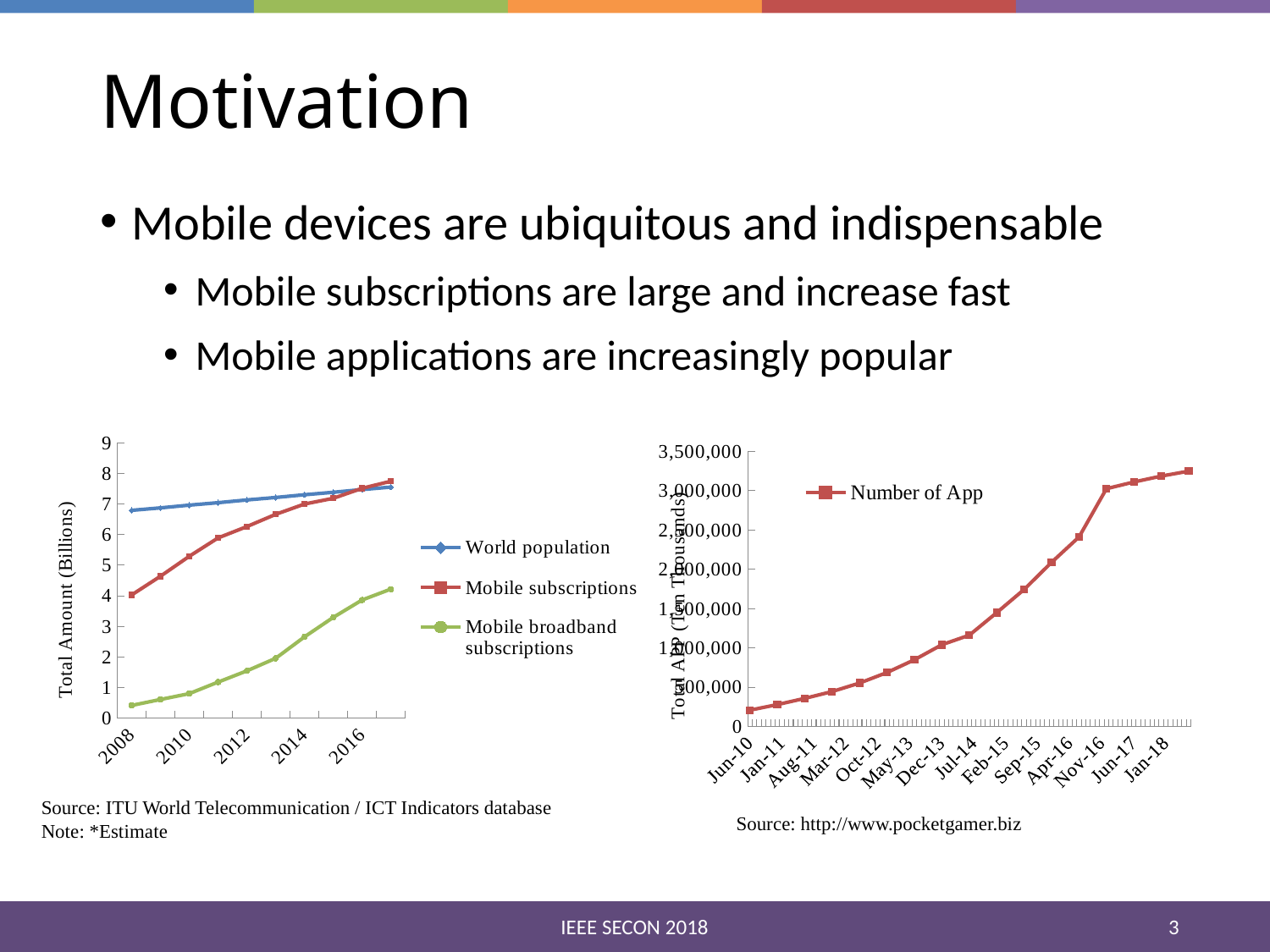
How many series does the legend of the left chart list? 3 In the left chart, do the Mobile broadband subscriptions values rise or fall from 2008 to 2017? rise In the left chart, is the value for World population in 2008 greater or less than 6? greater What kind of chart is the left chart (Total Amount in Billions)? line chart What kind of chart is the right chart (Number of App)? line chart In the left chart, is the value for Mobile subscriptions in 2008 greater or less than 3? greater In the left chart, is the value for Mobile broadband subscriptions in 2008 greater or less than 1? less In the left chart, which is larger in 2012: Mobile subscriptions or Mobile broadband subscriptions? Mobile subscriptions How many series does the legend of the right chart list? 1 In the left chart, which is larger in 2008: World population or Mobile subscriptions? World population